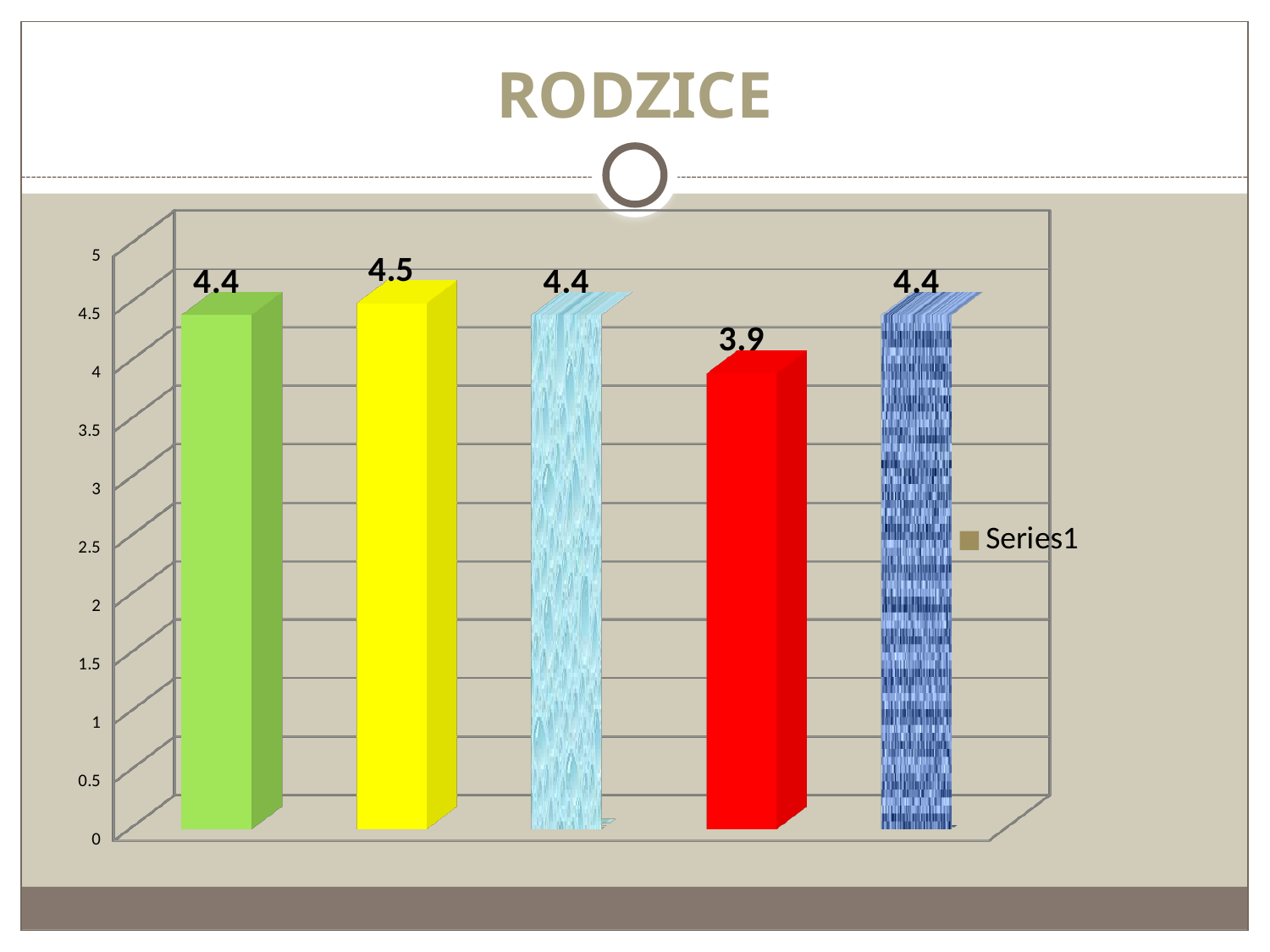
Is the value of the red bar greater or less than 4? less Which bar has the lowest value? the fourth (red) bar What is the value of the second (yellow) bar from the left? 4.5 What is the value of the fourth (red) bar from the left? 3.9 What is the difference between the value of the yellow bar and the red bar? 0.6 What type of chart is shown on the slide? bar chart What is the value of the first (green) bar from the left? 4.4 What is the value of the fifth (blue) bar from the left? 4.4 How many bars are plotted in the chart? 5 What is the name of the series shown in the legend? Series1 Which bar has the highest value? the second (yellow) bar How many series does the legend list? 1